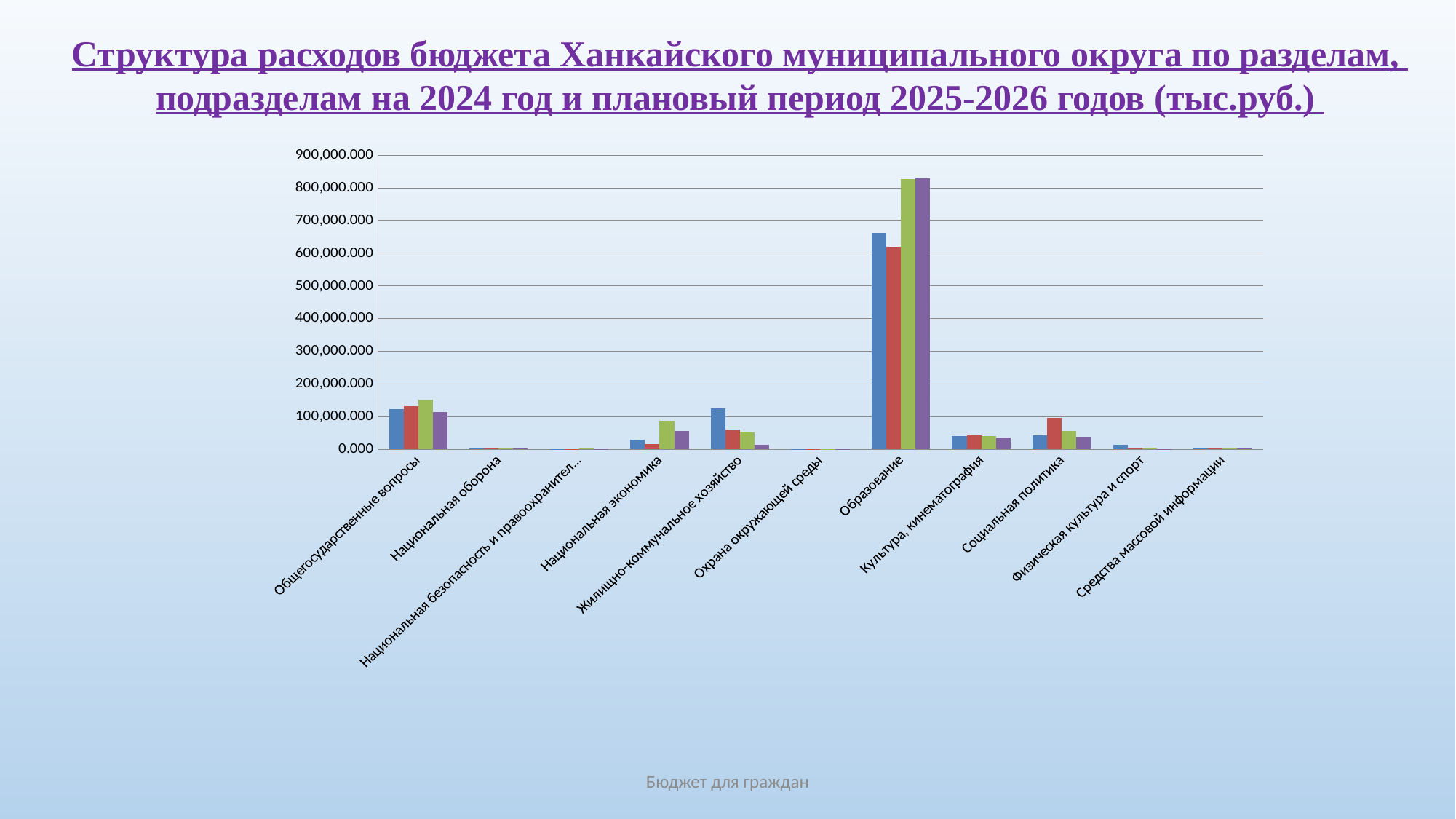
Is the value of the first (blue) bar for Образование greater or less than 600,000.000? greater How many bars are plotted for each category in the chart? 4 Is the value of the tallest bar for Образование greater or less than 800,000.000? greater Which category has larger values: Образование or Общегосударственные вопросы? Образование What is the highest tick value shown on the vertical axis of the chart? 900,000.000 Which category has the highest bars in the chart? Образование Is the value of the tallest bar for Национальная экономика greater or less than 100,000.000? less How many expenditure categories are shown along the x axis of the chart? 11 Which has the larger first (blue) bar: Жилищно-коммунальное хозяйство or Национальная экономика? Жилищно-коммунальное хозяйство What kind of chart is shown on the slide? bar chart